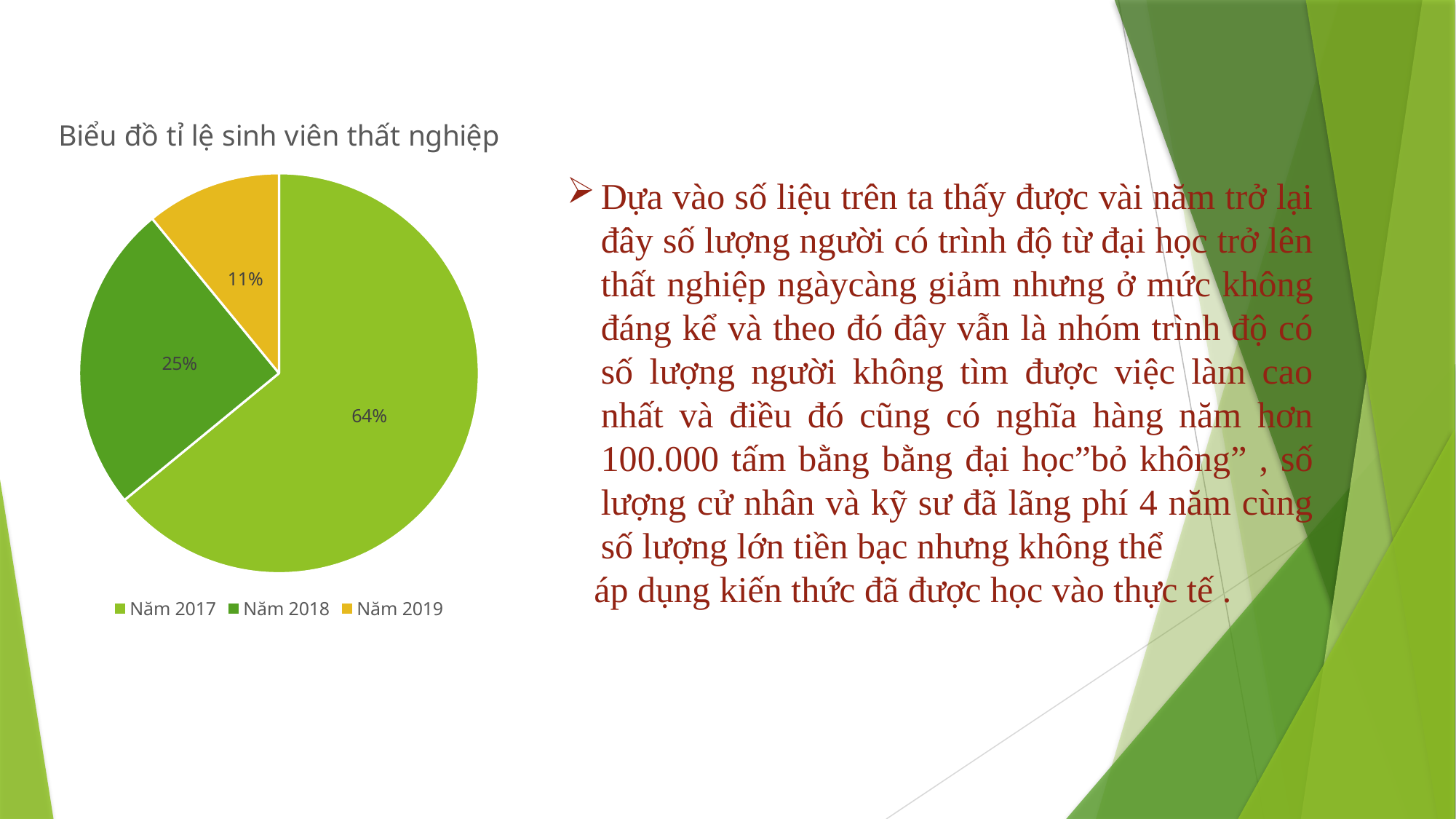
What is the value for Năm 2019 in the pie chart? 11% What is the value for Năm 2018 in the pie chart? 25% What is the difference between the values for Năm 2018 and Năm 2019? 14% What is the title of the chart? Biểu đồ tỉ lệ sinh viên thất nghiệp Which category has the largest slice of the pie chart? Năm 2017 Which is larger, the value for Năm 2018 or the value for Năm 2019? Năm 2018 What is the difference between the values for Năm 2017 and Năm 2018? 39% What is the value for Năm 2017 in the pie chart? 64% How many entries does the legend list? 3 How many slices does the pie chart have? 3 What kind of chart is shown on the slide? Pie chart Which category has the smallest slice of the pie chart? Năm 2019